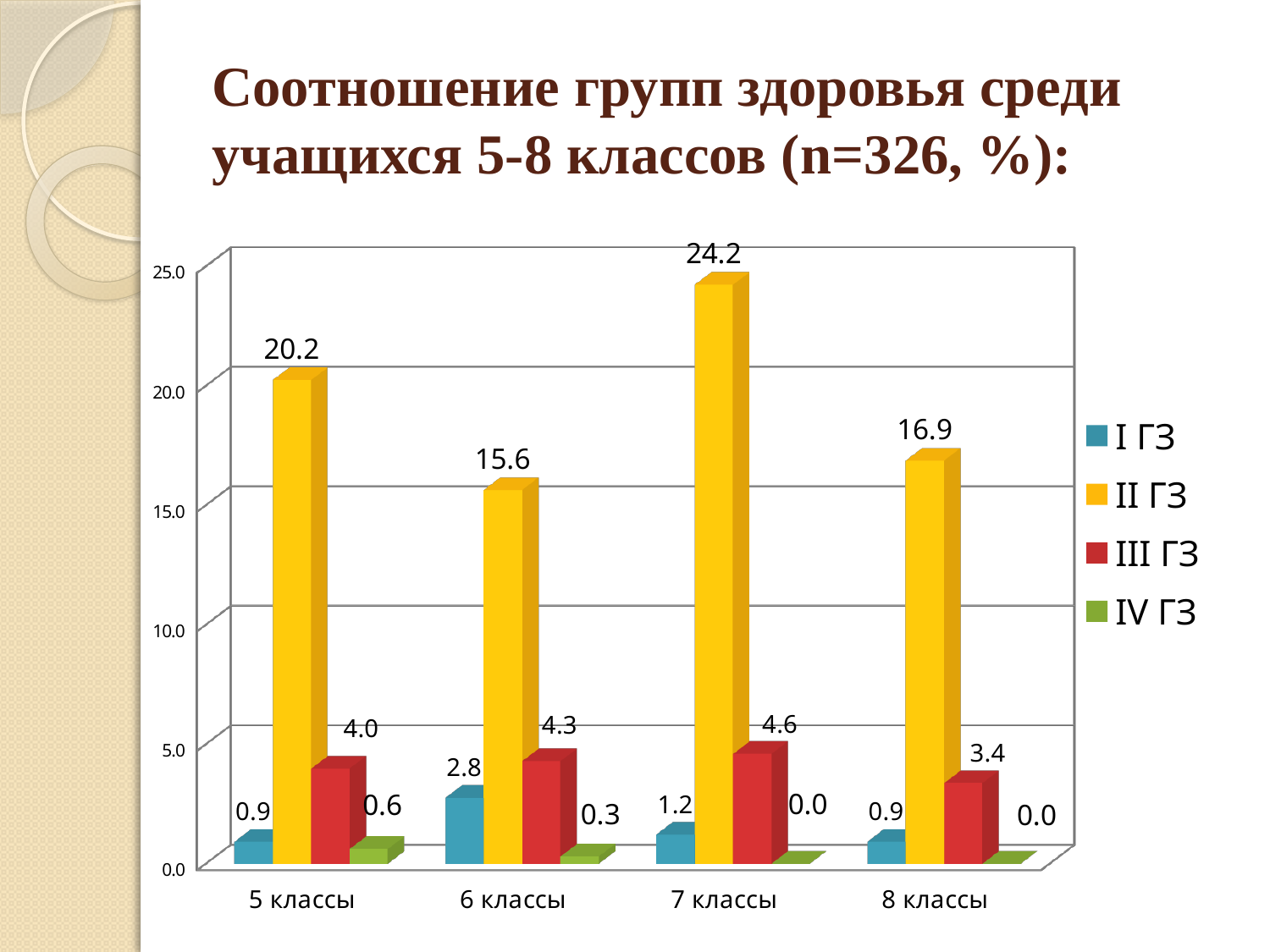
Which is larger: the I ГЗ value for 6 классы or the I ГЗ value for 7 классы? 6 классы What is the difference between the II ГЗ values for 7 классы and 8 классы? 7.3 Which colour represents III ГЗ in the legend? Red Which class group has the lowest value for II ГЗ? 6 классы How many series does the legend list? 4 Which class group has the highest value for II ГЗ? 7 классы What is the value for II ГЗ in 7 классы? 24.2 What is the value for IV ГЗ in 5 классы? 0.6 What kind of chart is shown on the slide? Bar chart What is the value for III ГЗ in 6 классы? 4.3 What is the value for I ГЗ in 8 классы? 0.9 How many class groups are shown on the x axis? 4